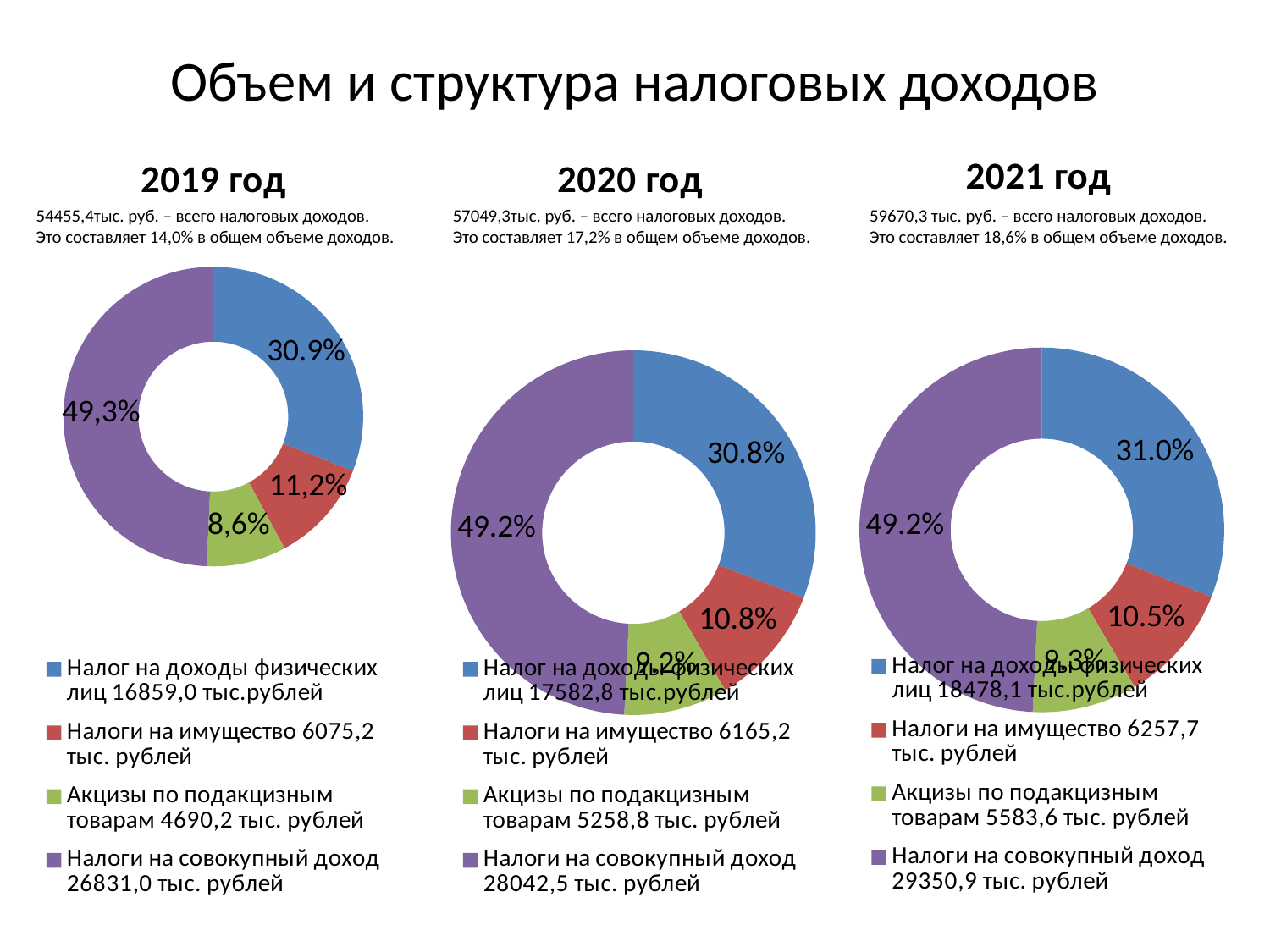
What kind of chart is used for the 2021 год data? Donut (pie) chart In the 2019 год chart, what is the difference between the share for Налог на доходы физических лиц and the share for Налоги на имущество? 19.7 percentage points How many categories does the legend of the 2020 год chart list? 4 In the 2020 год chart, what share is shown for Налог на доходы физических лиц? 30.8% How many charts are shown on the slide? 3 In the 2021 год chart, which is larger: the share for Налоги на имущество or the share for Акцизы по подакцизным товарам? Налоги на имущество In the 2019 год chart, which category has the largest share? Налоги на совокупный доход In the 2021 год chart, what share is shown for Налоги на имущество? 10.5% In the 2019 год chart, what share of tax revenue is shown for Налоги на совокупный доход? 49,3% In the 2020 год chart, which category has the smallest share? Акцизы по подакцизным товарам In the 2021 год chart, what share is shown for Акцизы по подакцизным товарам? 9.3% What colour represents Налоги на совокупный доход in the 2019 год chart? Purple